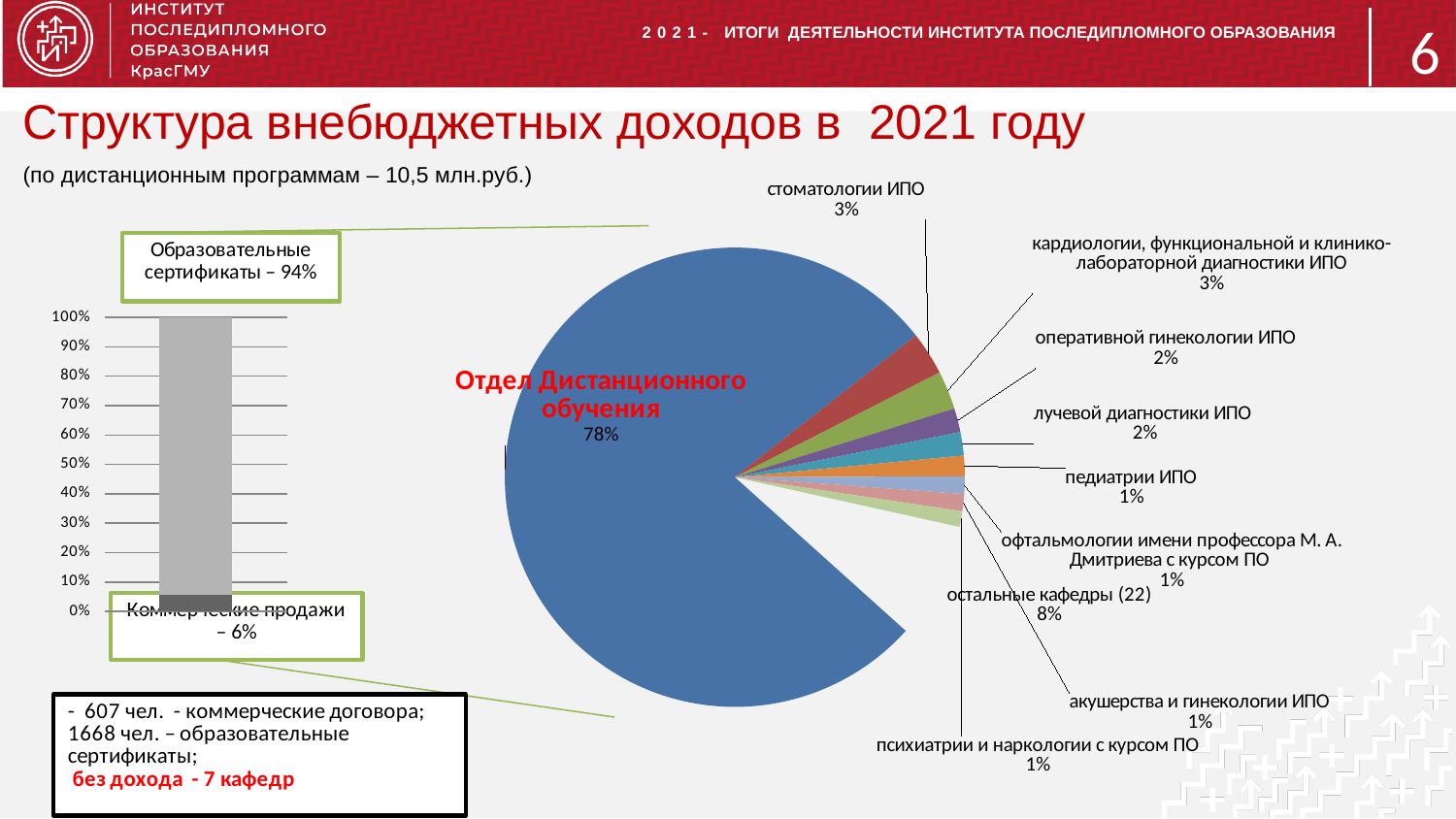
What type of chart is the chart on the left side of the slide? bar chart On the pie chart, what share is shown for лучевой диагностики ИПО? 2% On the pie chart, what share is shown for стоматологии ИПО? 3% On the pie chart, what share is shown for остальные кафедры (22)? 8% On the pie chart, what is the difference in percentage points between Отдел Дистанционного обучения and остальные кафедры (22)? 70 On the left bar chart, what share is shown for Коммерческие продажи? 6% On the pie chart, which slice is the largest? Отдел Дистанционного обучения On the pie chart, what share does Отдел Дистанционного обучения have? 78% On the pie chart, how many slices are labelled? 10 On the left bar chart, what share is shown for Образовательные сертификаты? 94% On the pie chart, which is larger: стоматологии ИПО or педиатрии ИПО? стоматологии ИПО What type of chart is the chart on the right side of the slide? pie chart